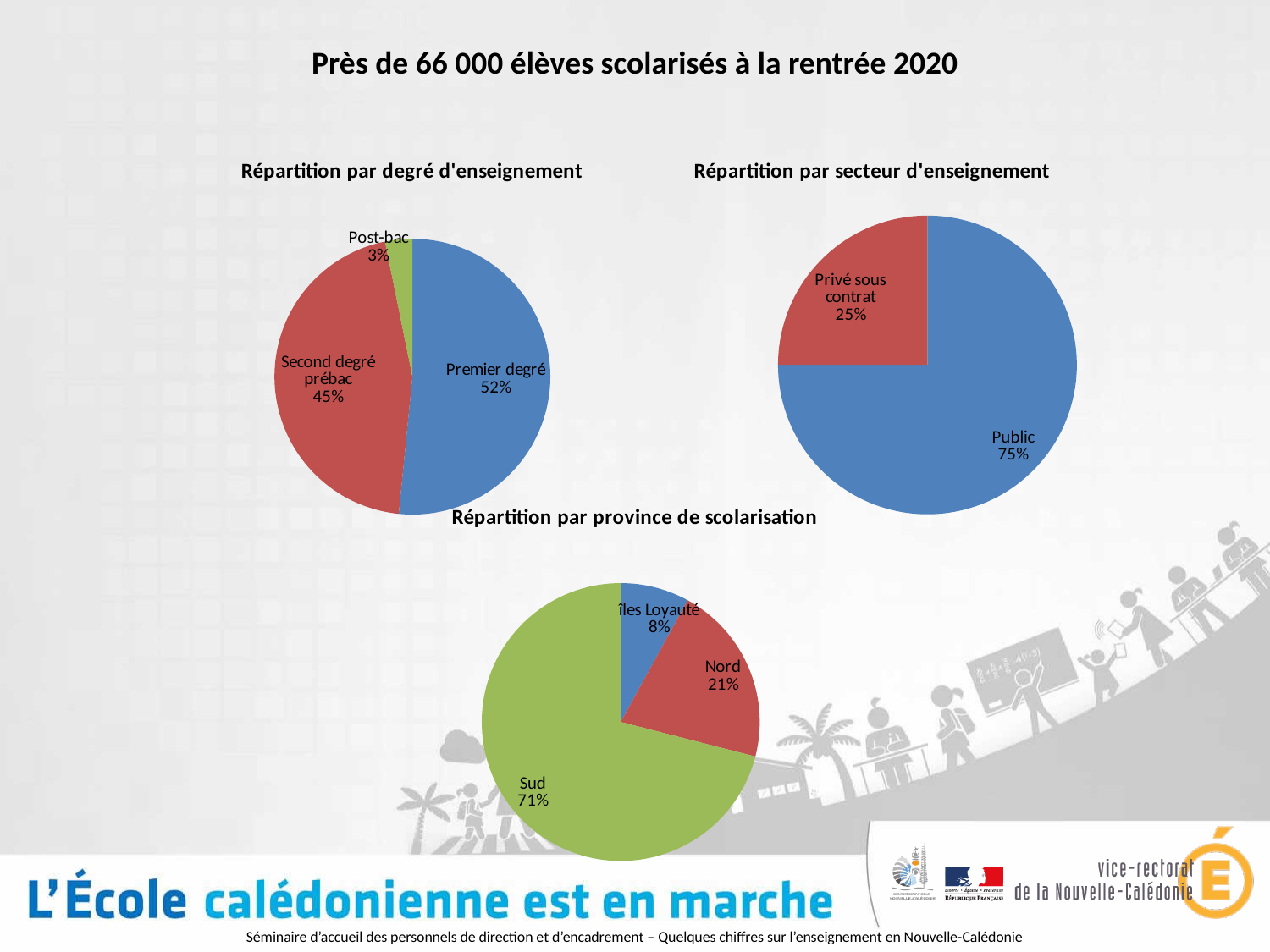
What type of chart is used for 'Répartition par degré d'enseignement'? Pie chart In the 'Répartition par secteur d'enseignement' chart, how many slices are there? 2 In the 'Répartition par degré d'enseignement' chart, what share is Premier degré? 52% In the 'Répartition par degré d'enseignement' chart, what share is Post-bac? 3% In the 'Répartition par secteur d'enseignement' chart, which sector has the largest share? Public In the 'Répartition par degré d'enseignement' chart, what is the difference between Premier degré and Second degré prébac? 7% In the 'Répartition par secteur d'enseignement' chart, what share is Privé sous contrat? 25% In the 'Répartition par province de scolarisation' chart, what share is Nord? 21% In the 'Répartition par province de scolarisation' chart, which is larger, Nord or îles Loyauté? Nord In the 'Répartition par province de scolarisation' chart, what is the difference between Sud and Nord? 50% In the 'Répartition par province de scolarisation' chart, which province has the largest share? Sud In the 'Répartition par degré d'enseignement' chart, which category has the smallest share? Post-bac